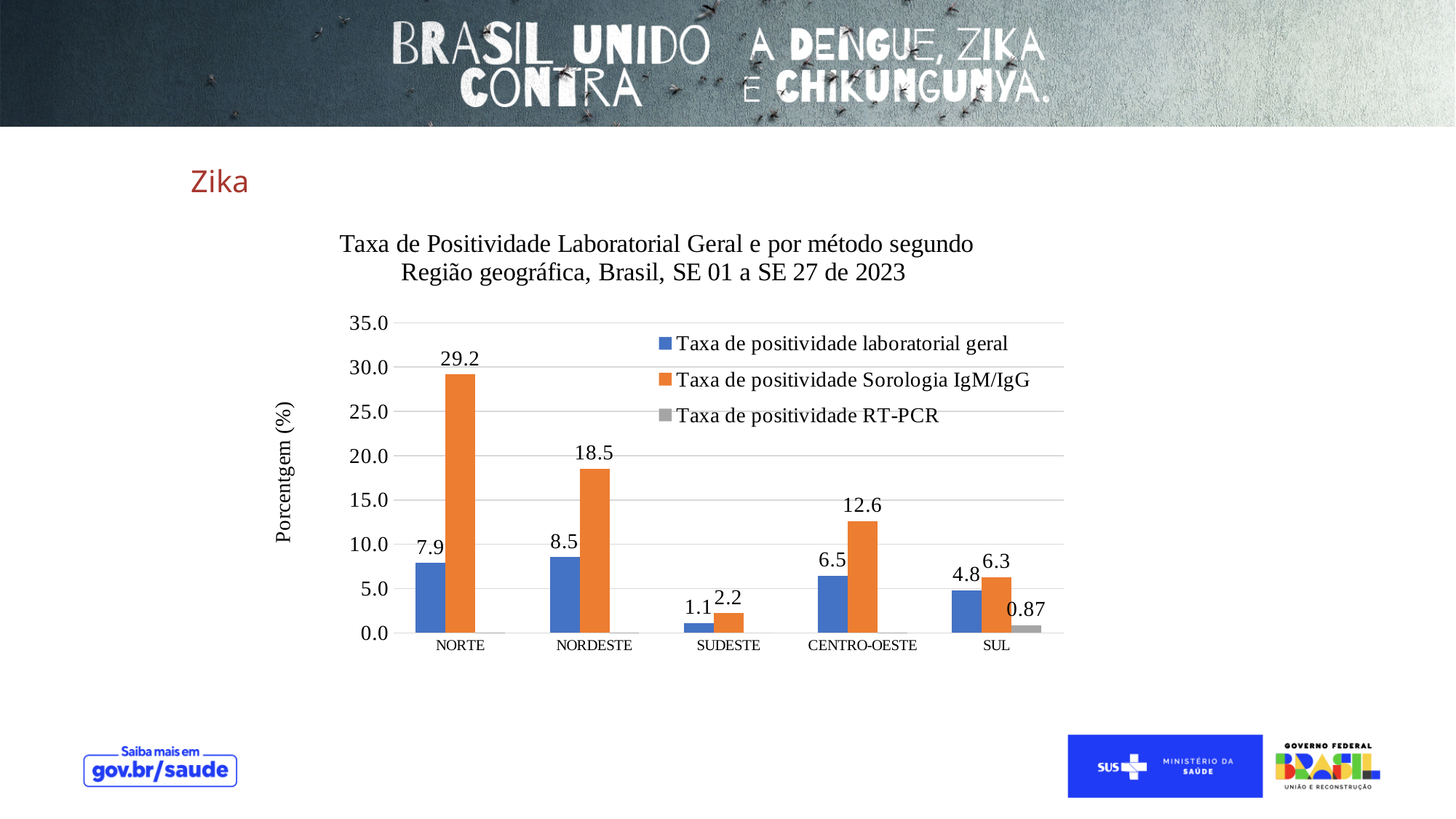
Which region has the lowest Taxa de positividade laboratorial geral? SUDESTE What is the label of the y axis? Porcentgem (%) How many series does the legend list? 3 Which region has the highest Taxa de positividade Sorologia IgM/IgG? NORTE Which is larger: the Taxa de positividade laboratorial geral for NORTE or for NORDESTE? NORDESTE How many regions are shown on the x axis? 5 What is the Taxa de positividade RT-PCR value for SUL? 0.87 What is the Taxa de positividade Sorologia IgM/IgG value for NORTE? 29.2 Is the Taxa de positividade Sorologia IgM/IgG value for NORDESTE greater or less than 15.0? greater What is the difference between the Sorologia IgM/IgG value and the laboratorial geral value for CENTRO-OESTE? 6.1 What is the Taxa de positividade laboratorial geral value for NORDESTE? 8.5 What kind of chart is shown on the slide? bar chart